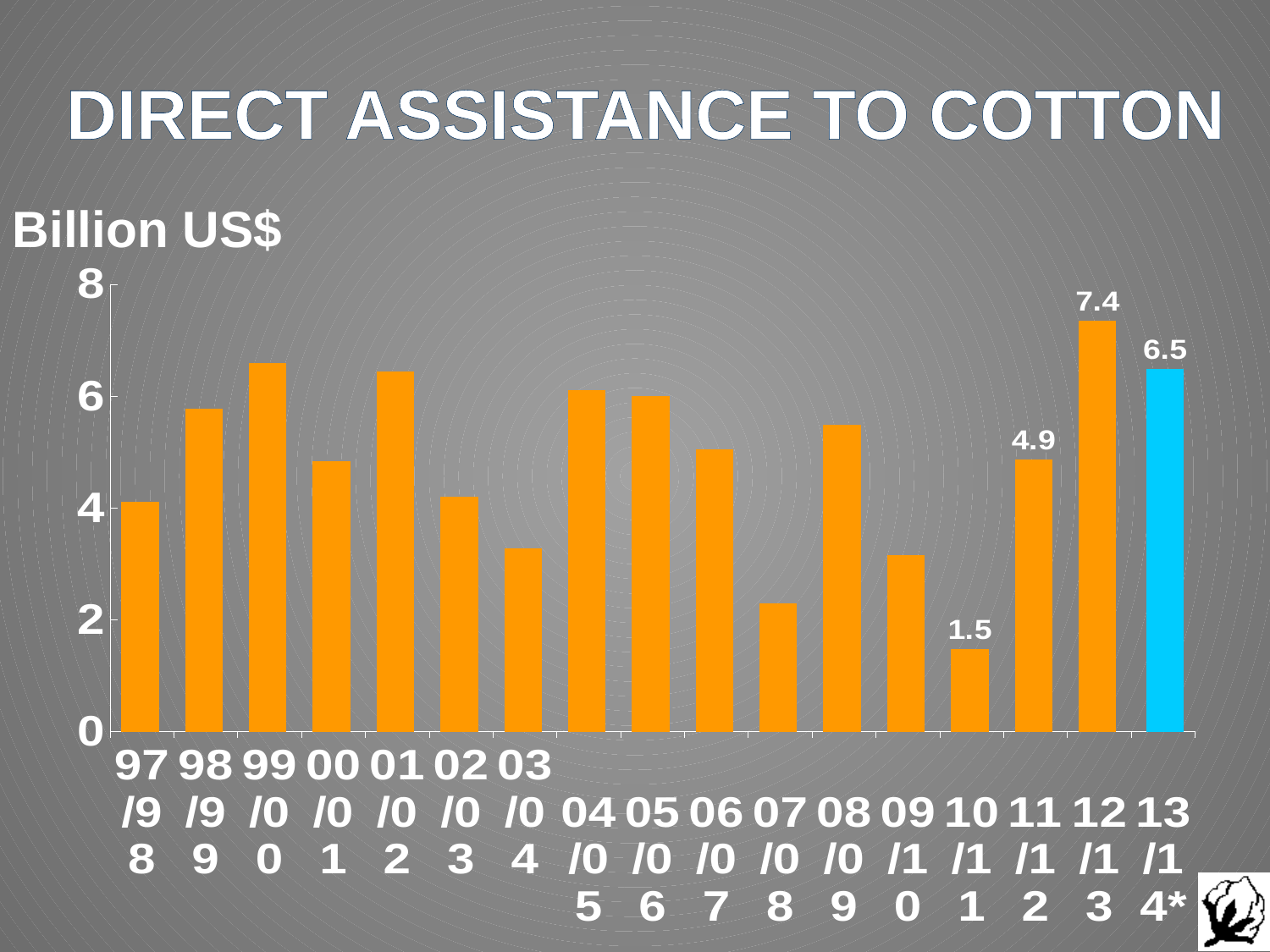
How many years are shown on the x axis? 17 Is the value for 07/08 greater or less than 4? less What is the difference between the values for 12/13 and 13/14*? 0.9 What is the value for 11/12? 4.9 Which year has the highest value? 12/13 What is the value for 10/11? 1.5 What is the value for 13/14*? 6.5 Which is larger, the value for 12/13 or the value for 13/14*? 12/13 Is the value for 99/00 greater or less than 6? greater What kind of chart is this? bar chart What is the value for 12/13? 7.4 Which year has the lowest value? 10/11